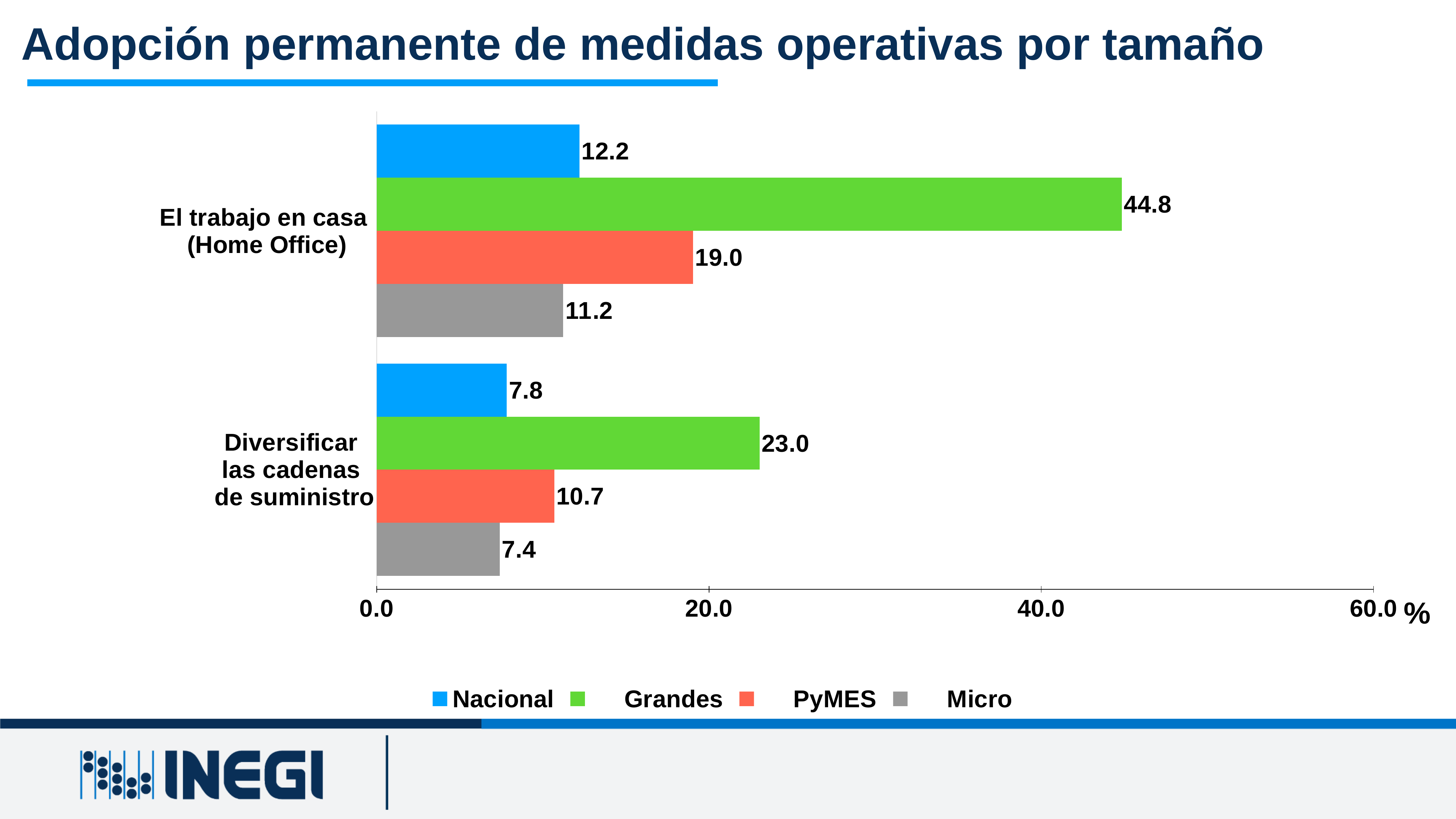
What is the value for Micro in the 'Diversificar las cadenas de suministro' category? 7.4 What kind of chart is shown on the slide? Bar chart Is the Grandes value for 'El trabajo en casa (Home Office)' greater or less than 40.0? greater Which series has the highest value for 'El trabajo en casa (Home Office)'? Grandes How many series does the legend list? 4 How many categories are shown on the chart? 2 What is the value for Grandes in the 'El trabajo en casa (Home Office)' category? 44.8 What is the difference between the Grandes and PyMES values for 'El trabajo en casa (Home Office)'? 25.8 What is the difference between the Grandes values for 'El trabajo en casa (Home Office)' and 'Diversificar las cadenas de suministro'? 21.8 Which series has the lowest value for 'Diversificar las cadenas de suministro'? Micro Which is larger: the PyMES value for 'El trabajo en casa (Home Office)' or the Grandes value for 'Diversificar las cadenas de suministro'? Grandes value for 'Diversificar las cadenas de suministro' What is the Nacional value for 'Diversificar las cadenas de suministro'? 7.8